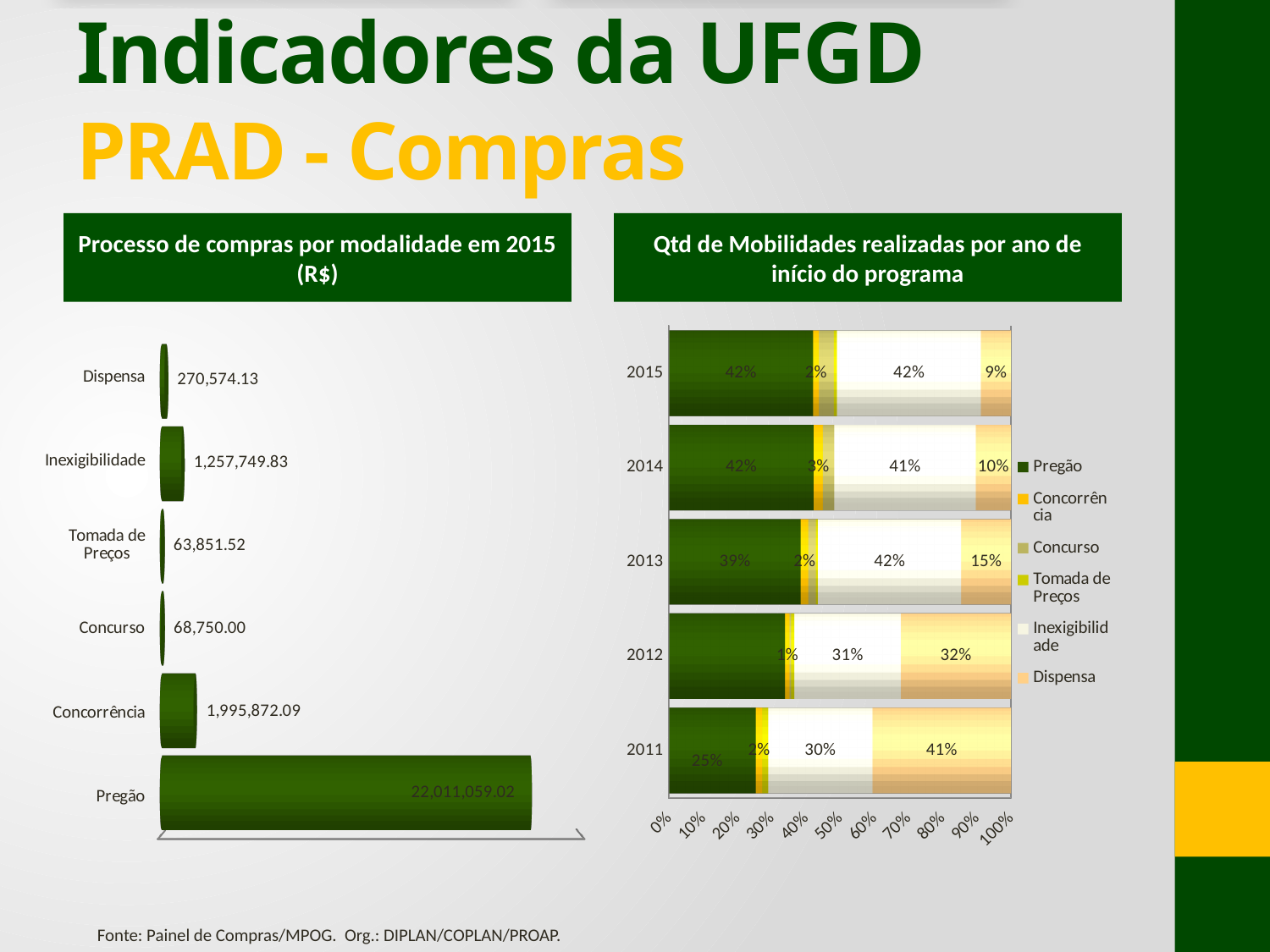
In the chart 'Processo de compras por modalidade em 2015 (R$)', what is the difference between the values for Concorrência and Inexigibilidade? 738,122.26 What kind of chart is 'Processo de compras por modalidade em 2015 (R$)'? Bar chart In the chart 'Processo de compras por modalidade em 2015 (R$)', what is the value for Pregão? 22,011,059.02 In the chart 'Qtd de Mobilidades realizadas por ano de início do programa', which year has the largest Dispensa share? 2011 In the chart 'Processo de compras por modalidade em 2015 (R$)', what is the value for Concorrência? 1,995,872.09 In the chart 'Qtd de Mobilidades realizadas por ano de início do programa', what is the Dispensa share for 2011? 41% In the chart 'Qtd de Mobilidades realizadas por ano de início do programa', what is the Inexigibilidade share for 2013? 42% How many modalities are shown in the chart 'Processo de compras por modalidade em 2015 (R$)'? 6 In the chart 'Qtd de Mobilidades realizadas por ano de início do programa', is the Pregão share larger in 2015 or in 2011? 2015 In the chart 'Processo de compras por modalidade em 2015 (R$)', which modality has the highest value? Pregão In the chart 'Processo de compras por modalidade em 2015 (R$)', which modality has the lowest value? Tomada de Preços How many series does the legend list in the chart 'Qtd de Mobilidades realizadas por ano de início do programa'? 6